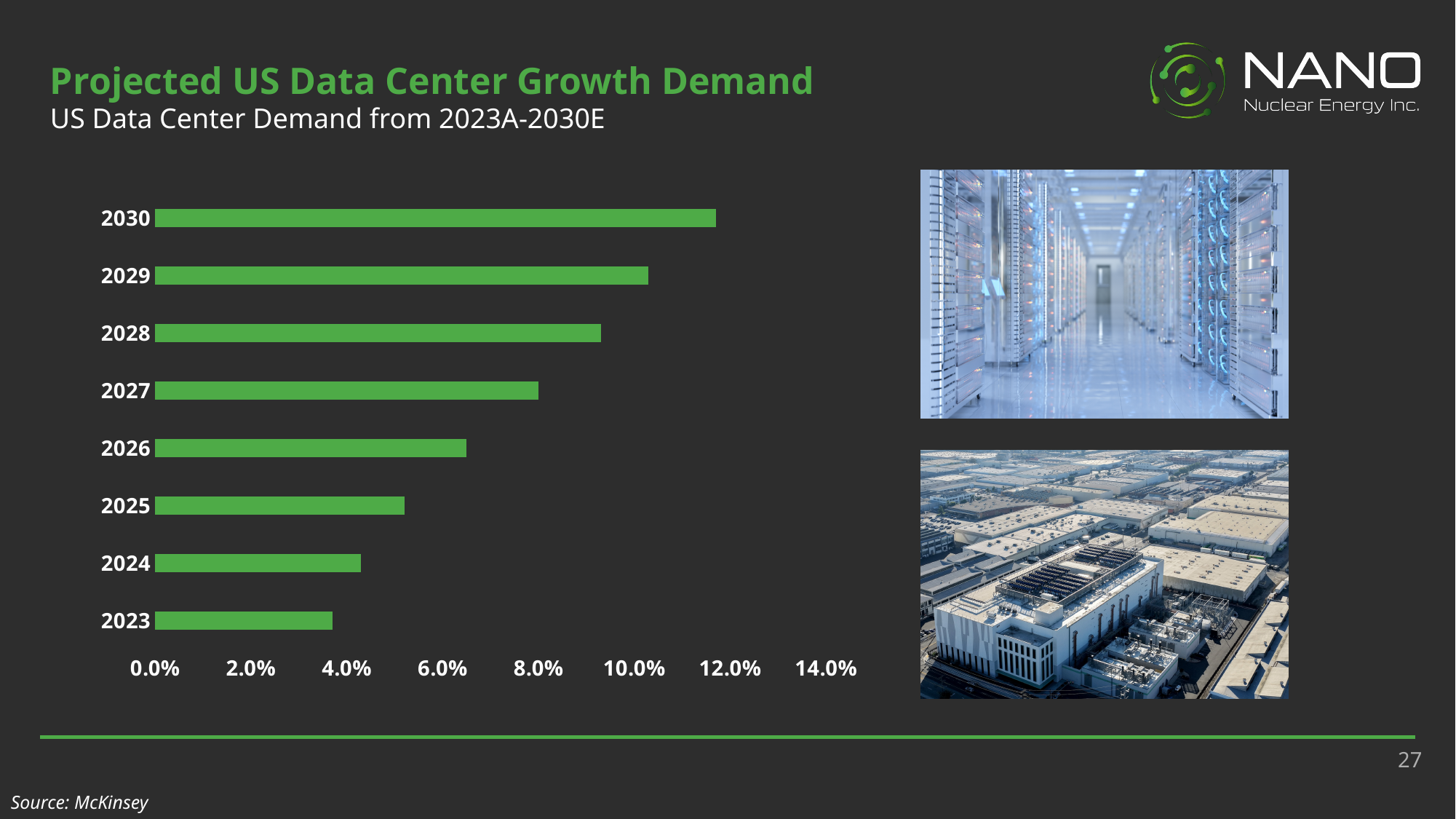
Is the value for 2028 greater or less than 8.0%? greater How many years are plotted in the chart? 8 Which year has the highest projected US data center demand? 2030 What is the title of the chart on the slide? Projected US Data Center Growth Demand Which year has the lowest projected US data center demand? 2023 Which is larger, the value for 2028 or the value for 2025? 2028 Is the value for 2027 greater or less than 10.0%? less Is the value for 2023 greater or less than 4.0%? less What kind of chart is shown on the slide? Bar chart Do the values rise or fall from 2023 to 2030? Rise